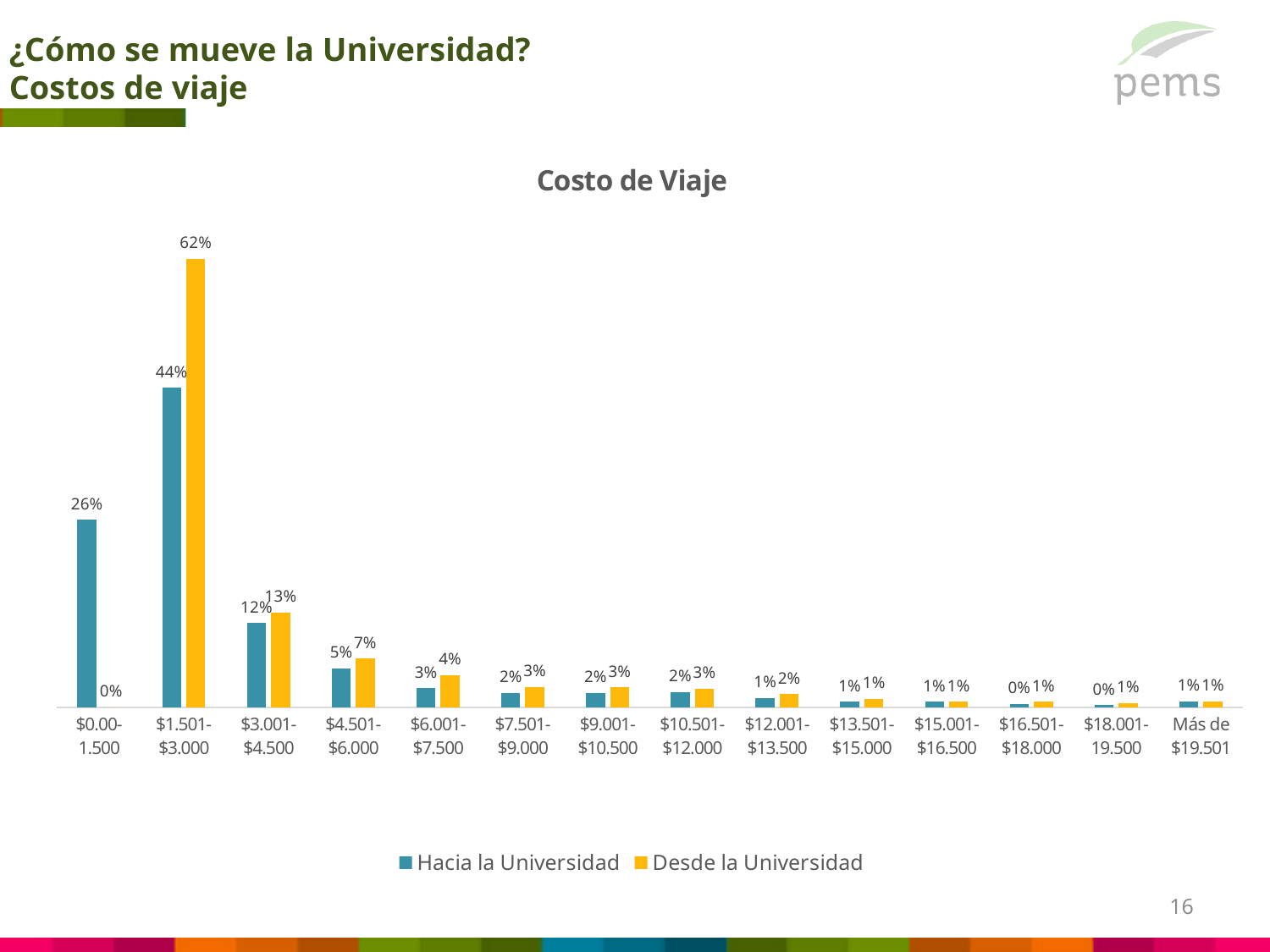
What is the value for Hacia la Universidad in the $3.001-$4.500 category? 12% In the $0.00-1.500 category, which series has the larger value, Hacia la Universidad or Desde la Universidad? Hacia la Universidad Which category has the highest value for Desde la Universidad? $1.501-$3.000 What is the value for Desde la Universidad in the $1.501-$3.000 category? 62% What is the value for Hacia la Universidad in the $0.00-1.500 category? 26% How many cost categories are shown on the x axis? 14 What is the value for Desde la Universidad in the $4.501-$6.000 category? 7% What is the title of the chart? Costo de Viaje How many series does the legend list? 2 What kind of chart is shown on the slide? Bar chart Which category has the highest value for Hacia la Universidad? $1.501-$3.000 What is the difference between Desde la Universidad and Hacia la Universidad in the $1.501-$3.000 category? 18%